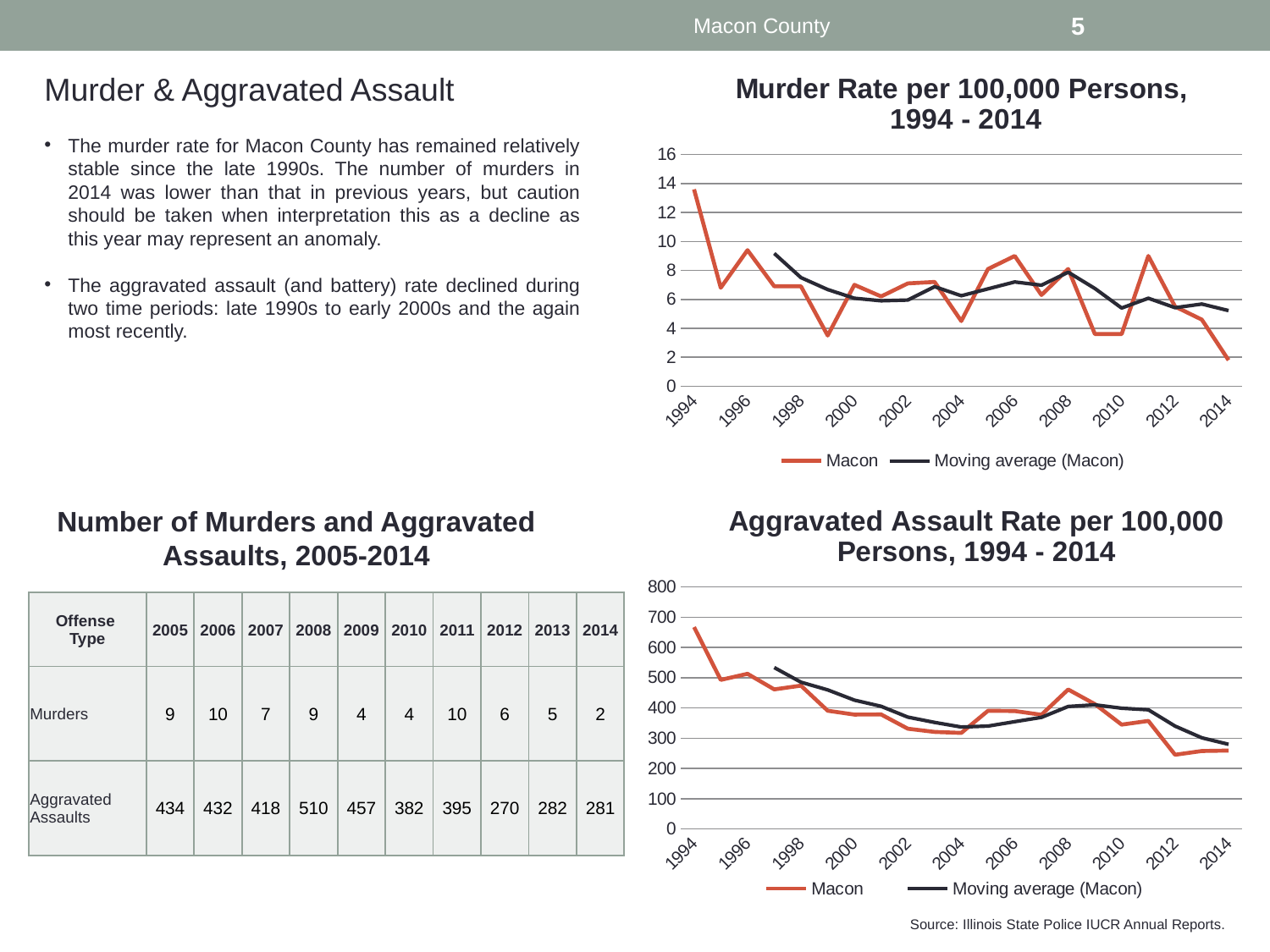
What kind of chart is the 'Murder Rate per 100,000 Persons, 1994 - 2014' chart? Line chart In the 'Murder Rate per 100,000 Persons, 1994 - 2014' chart, which year has the lowest Macon murder rate? 2014 In the 'Aggravated Assault Rate per 100,000 Persons, 1994 - 2014' chart, which year has the highest Macon aggravated assault rate? 1994 What are the two legend entries in the 'Aggravated Assault Rate per 100,000 Persons, 1994 - 2014' chart? Macon and Moving average (Macon) How many series does the legend of the 'Murder Rate per 100,000 Persons, 1994 - 2014' chart list? 2 In the 'Aggravated Assault Rate per 100,000 Persons, 1994 - 2014' chart, is the Macon value for 2012 greater or less than 300? less In the 'Aggravated Assault Rate per 100,000 Persons, 1994 - 2014' chart, does the Macon aggravated assault rate generally rise or fall from 1994 to 2014? Fall In the 'Murder Rate per 100,000 Persons, 1994 - 2014' chart, is the Macon value for 2014 greater or less than 4? less In the 'Murder Rate per 100,000 Persons, 1994 - 2014' chart, which year has the highest Macon murder rate? 1994 In the 'Murder Rate per 100,000 Persons, 1994 - 2014' chart, is the Macon value for 1994 greater or less than 12? greater What kind of chart is the 'Aggravated Assault Rate per 100,000 Persons, 1994 - 2014' chart? Line chart